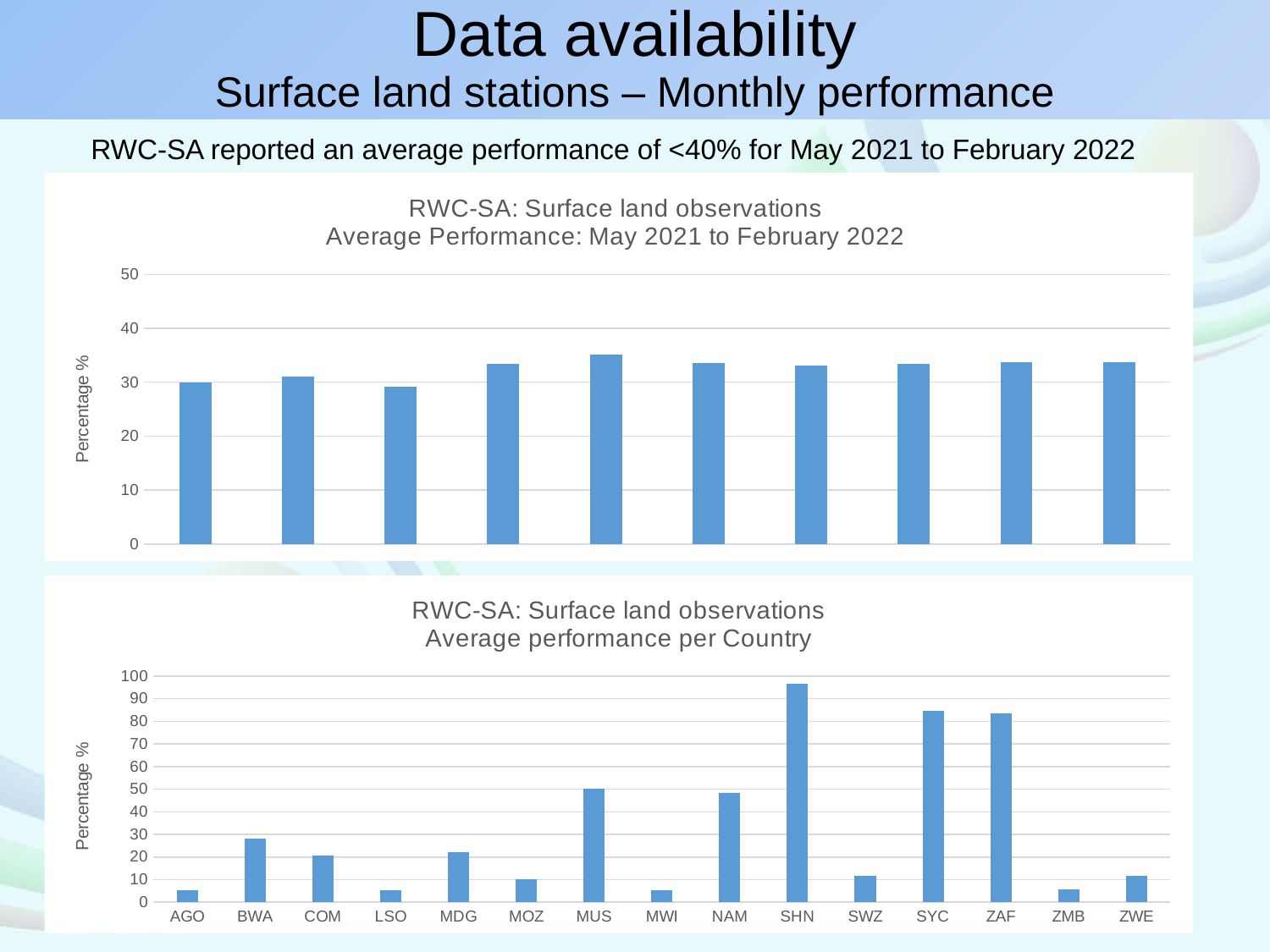
What is the y-axis label of the top chart, 'Average Performance: May 2021 to February 2022'? Percentage % In the top chart, 'Average Performance: May 2021 to February 2022', how many bars are plotted? 10 In the bottom chart, 'Average performance per Country', how many countries are shown on the x axis? 15 What kind of chart is the bottom chart, 'Average performance per Country'? bar chart In the bottom chart, 'Average performance per Country', which is larger, the value for SHN or the value for SYC? SHN In the bottom chart, 'Average performance per Country', which country has the highest average performance? SHN In the bottom chart, 'Average performance per Country', is the value for SYC greater or less than 80? greater In the bottom chart, 'Average performance per Country', is the value for COM greater or less than 30? less In the bottom chart, 'Average performance per Country', is the value for NAM greater or less than 40? greater In the bottom chart, 'Average performance per Country', which is larger, the value for BWA or the value for COM? BWA